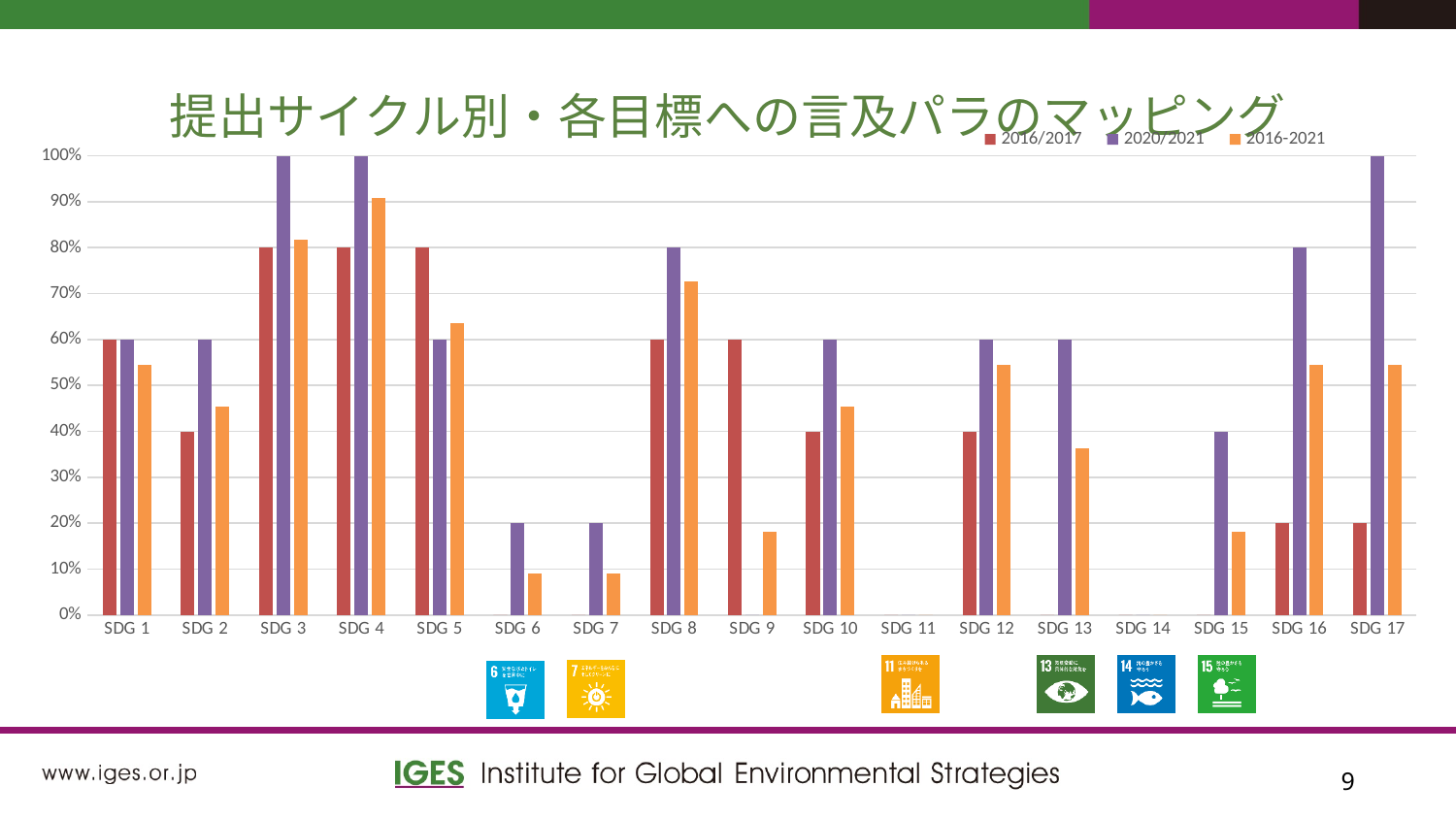
What is the difference between the 2020/2021 value and the 2016/2017 value for SDG 8? 20% Which is larger for SDG 5: the 2016/2017 value or the 2020/2021 value? 2016/2017 How many SDG categories are shown on the x axis? 17 Is the 2016-2021 value for SDG 13 greater or less than 40%? less Which series is shown in orange in the legend? 2016-2021 How many series does the legend list? 3 What is the value for SDG 6 in the 2020/2021 series? 20% What kind of chart is shown on the slide? bar chart Which is larger for SDG 17: the 2016/2017 value or the 2020/2021 value? 2020/2021 What is the value for SDG 3 in the 2020/2021 series? 100% What is the value for SDG 5 in the 2016/2017 series? 80%